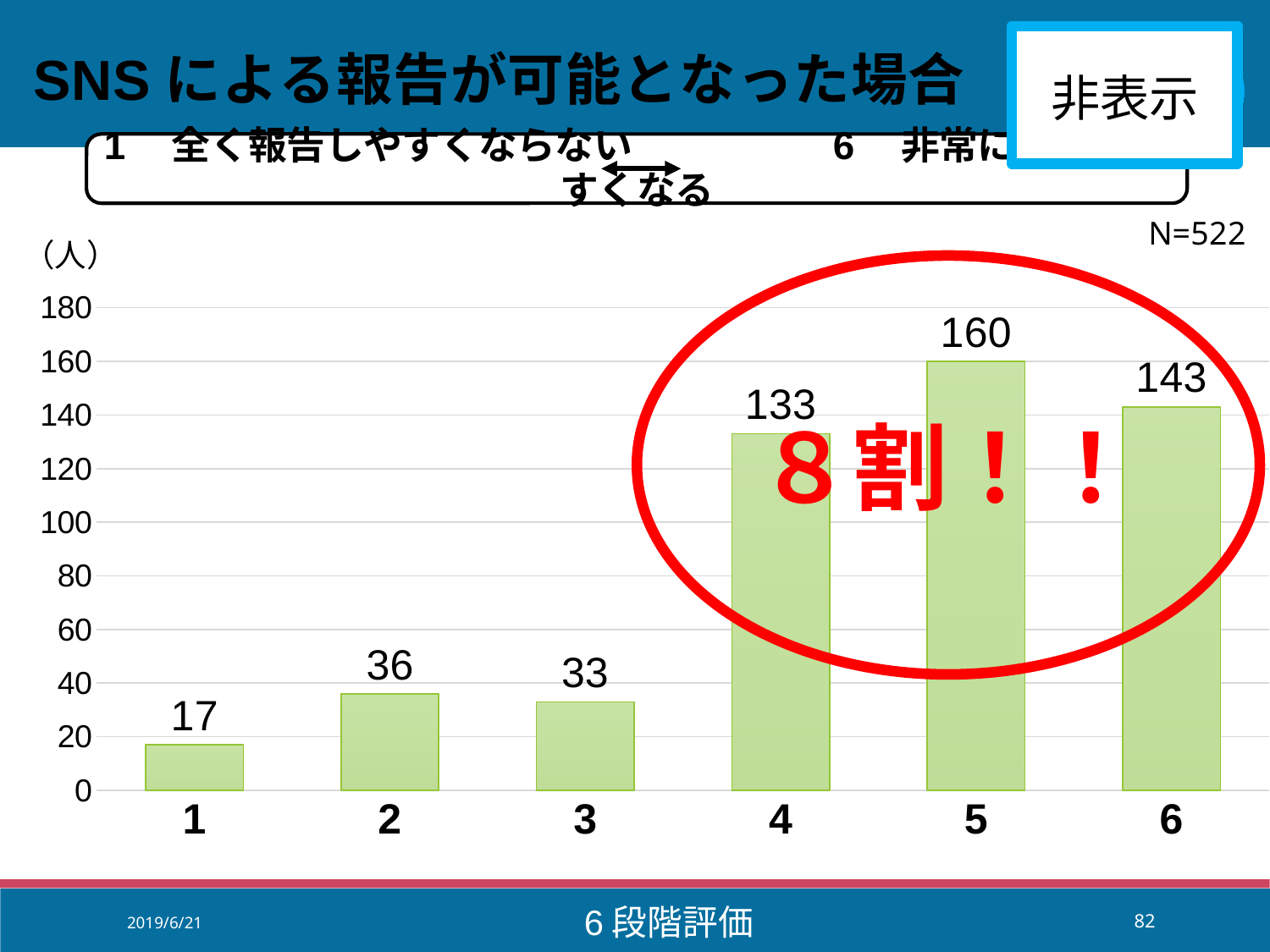
What kind of chart is shown on the slide? bar chart Which category has the highest value? 5 What is the difference between the values for category 5 and category 6? 17 How many categories are shown on the x axis? 6 What is the value for category 5? 160 Which category has the lowest value? 1 What is the difference between the values for category 2 and category 3? 3 What is the value for category 4? 133 Which is larger, the value for category 4 or the value for category 6? 6 What is the value for category 1? 17 What is the sample size (N) shown on the slide? N=522 Is the value for category 6 greater or less than 140? greater